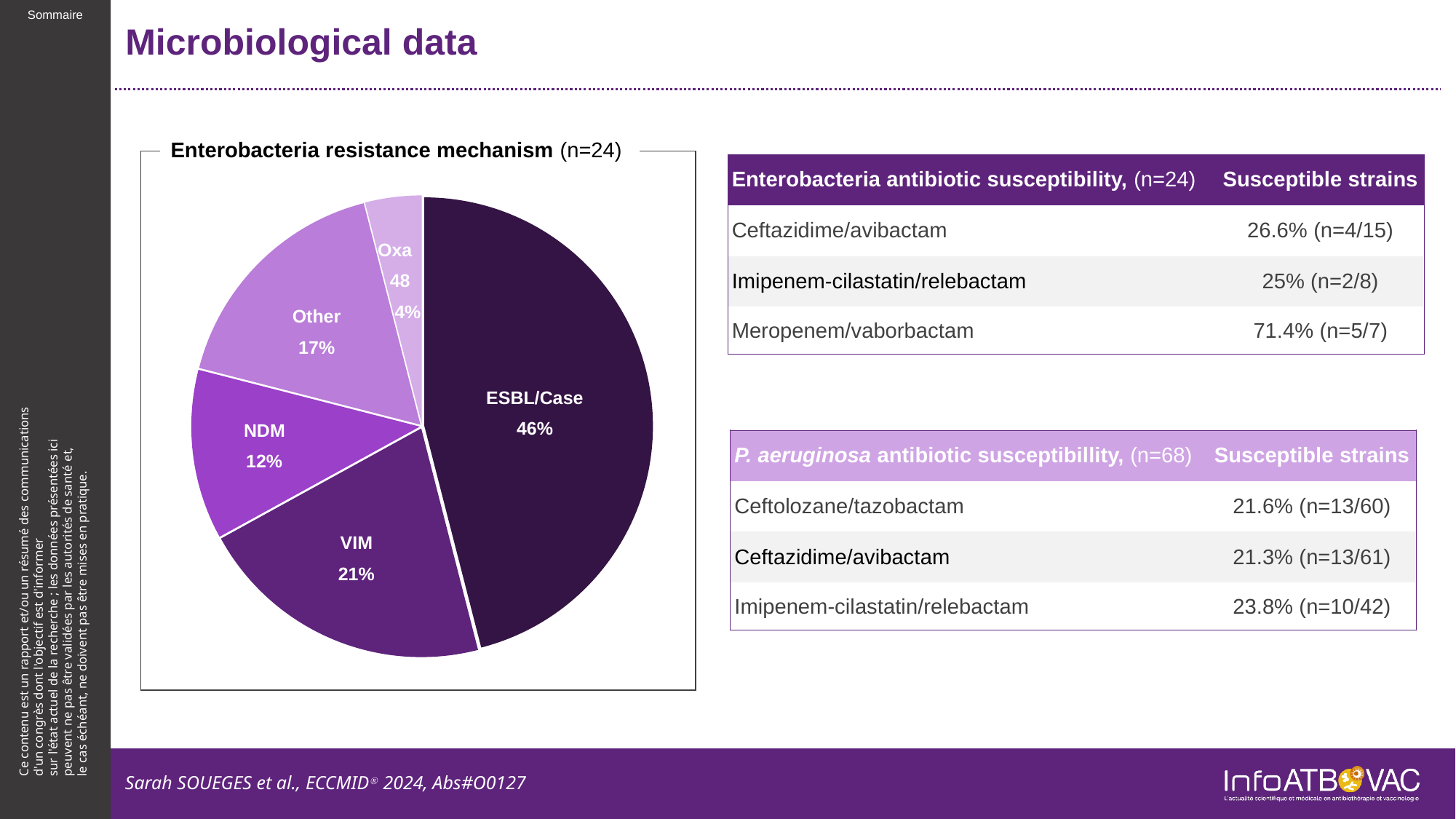
What share of the pie does NDM represent? 12% Which resistance mechanism has the largest slice of the pie? ESBL/Case What is the title of the pie chart? Enterobacteria resistance mechanism (n=24) What share of the pie does Other represent? 17% How many slices does the pie chart have? 5 Which resistance mechanism has the smallest slice of the pie? Oxa 48 Which slice is larger, Other or NDM? Other What share of the pie does ESBL/Case represent? 46% What kind of chart is shown on the slide? pie chart What is the difference in percentage points between the ESBL/Case slice and the VIM slice? 25